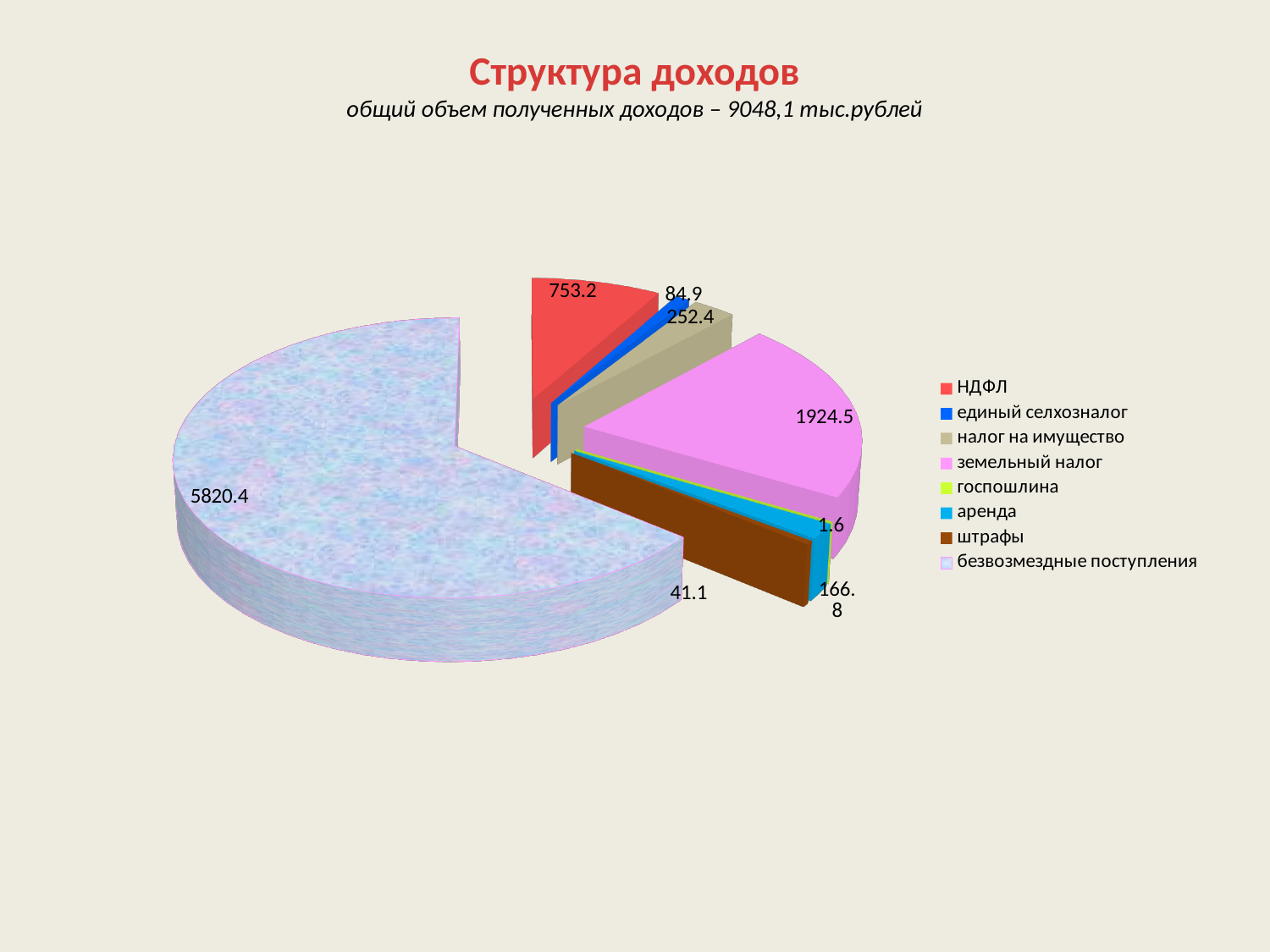
What is the value for НДФЛ? 753.2 What is the title of the chart? Структура доходов What kind of chart is shown on the slide? pie chart What is the value for аренда? 166.8 What is the difference between the values for земельный налог and НДФЛ? 1171.3 What is the value for земельный налог? 1924.5 What is the value for безвозмездные поступления? 5820.4 How many categories does the legend list? 8 Which category has the largest slice of the pie? безвозмездные поступления Which category has the smallest value? госпошлина Which is larger, the value for единый селхозналог or the value for штрафы? единый селхозналог What is the value for налог на имущество? 252.4